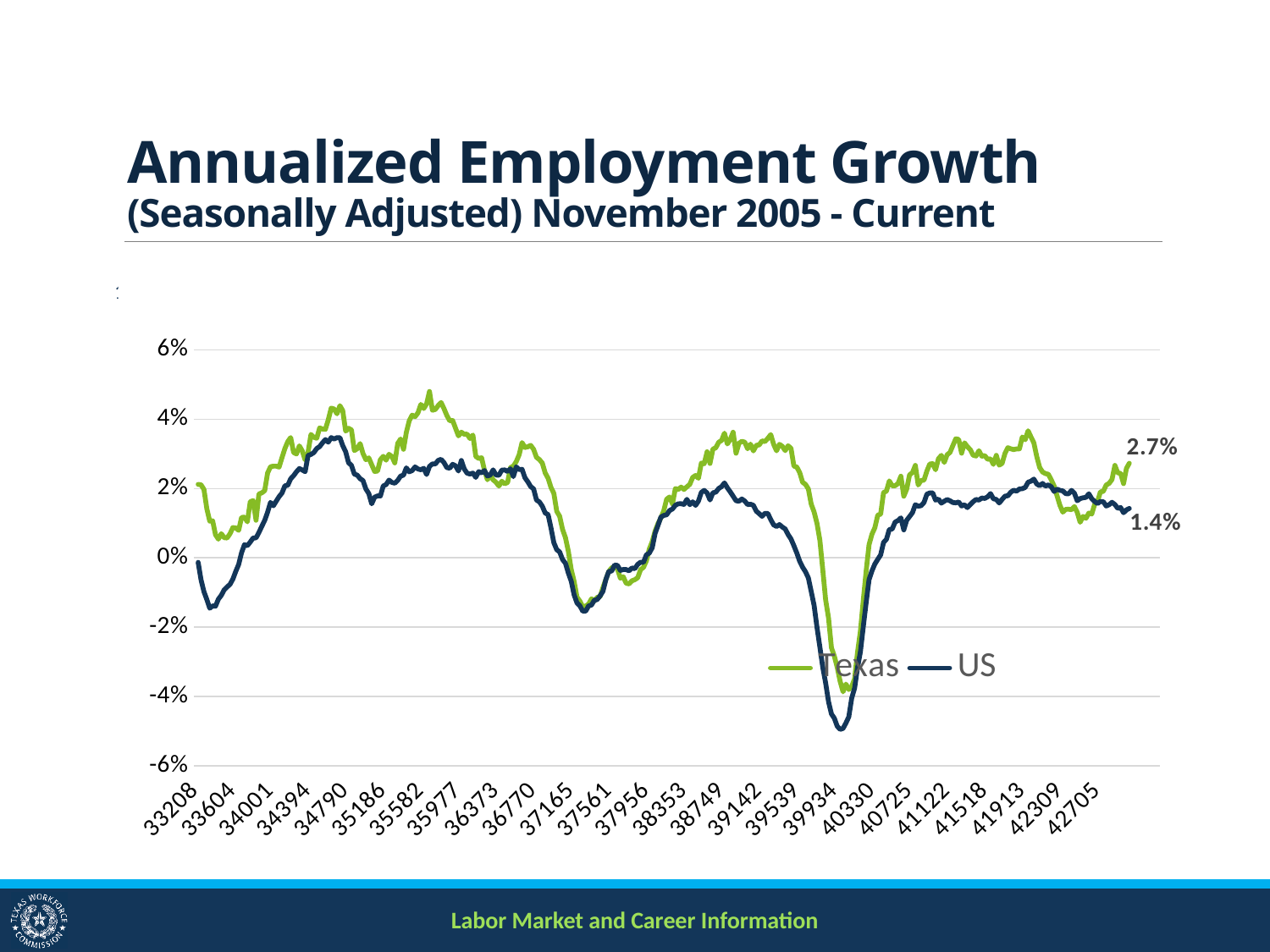
What is the difference between the latest labeled Texas value and the latest labeled US value? 1.3% Is the lowest value of the US line greater or less than -4%? less Which series reaches the lowest point on the chart? US What kind of chart is shown on the slide? line chart What are the two series named in the legend? Texas and US Is the latest labeled US value greater or less than 2%? less How many series does the legend list? 2 What is the highest value shown on the vertical axis? 6% At the end of the series, which has the higher labeled value, Texas or US? Texas Is the highest value of the Texas line greater or less than 4%? greater What is the most recent annualized employment growth value labeled for the US? 1.4% What is the most recent annualized employment growth value labeled for Texas? 2.7%